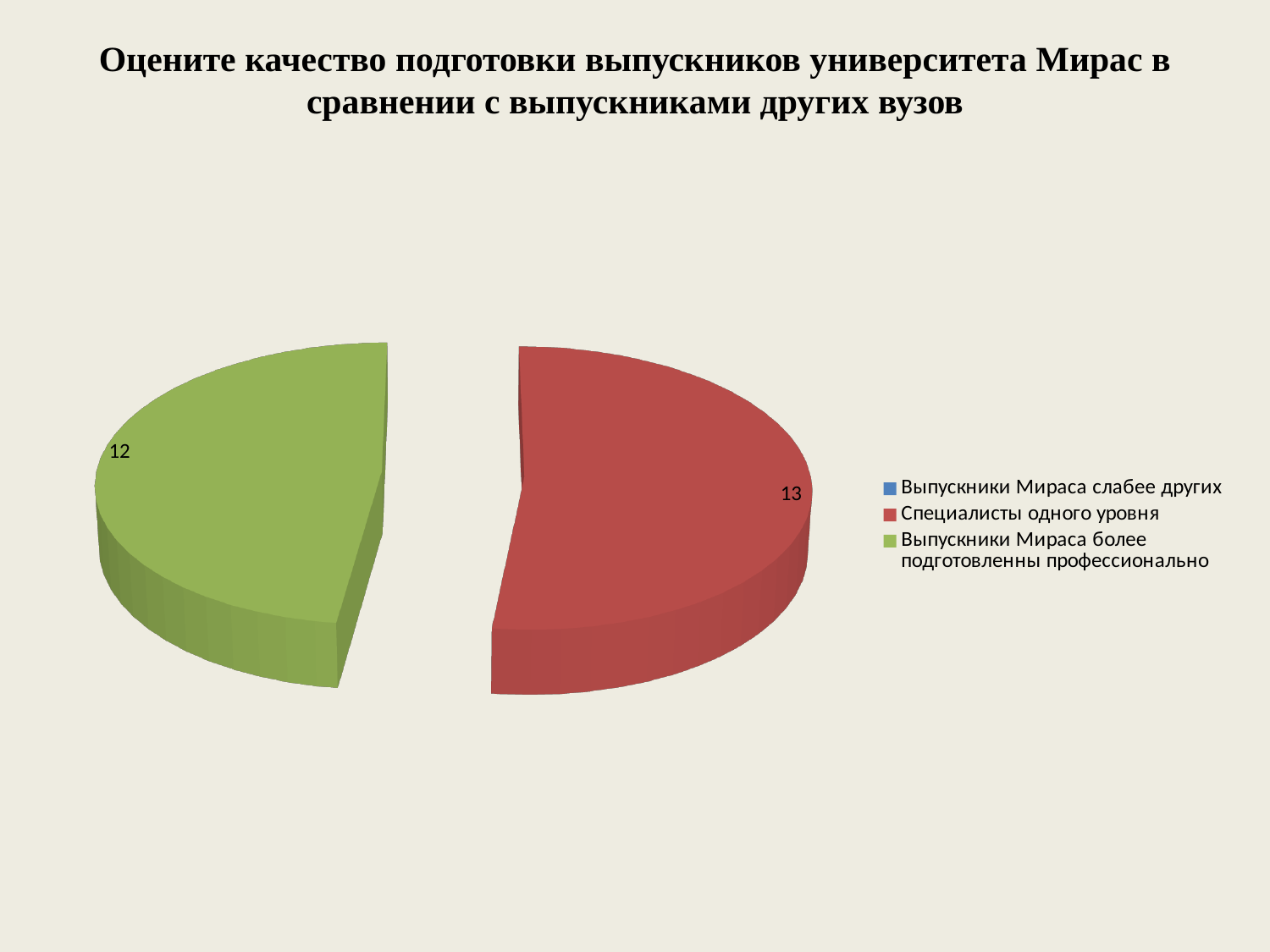
Which legend entry is shown in green? Выпускники Мираса более подготовленны профессионально What kind of chart is shown on the slide? Pie chart What colour is the slice for "Специалисты одного уровня"? Red Which category has the largest slice in the pie chart? Специалисты одного уровня How many entries does the legend list? 3 What value is shown for the slice "Специалисты одного уровня"? 13 What is the difference between the values for "Специалисты одного уровня" and "Выпускники Мираса более подготовленны профессионально"? 1 Which is larger: the value for "Специалисты одного уровня" or for "Выпускники Мираса более подготовленны профессионально"? Специалисты одного уровня What value is shown for the slice "Выпускники Мираса более подготовленны профессионально"? 12 How many slices with data labels are visible in the pie chart? 2